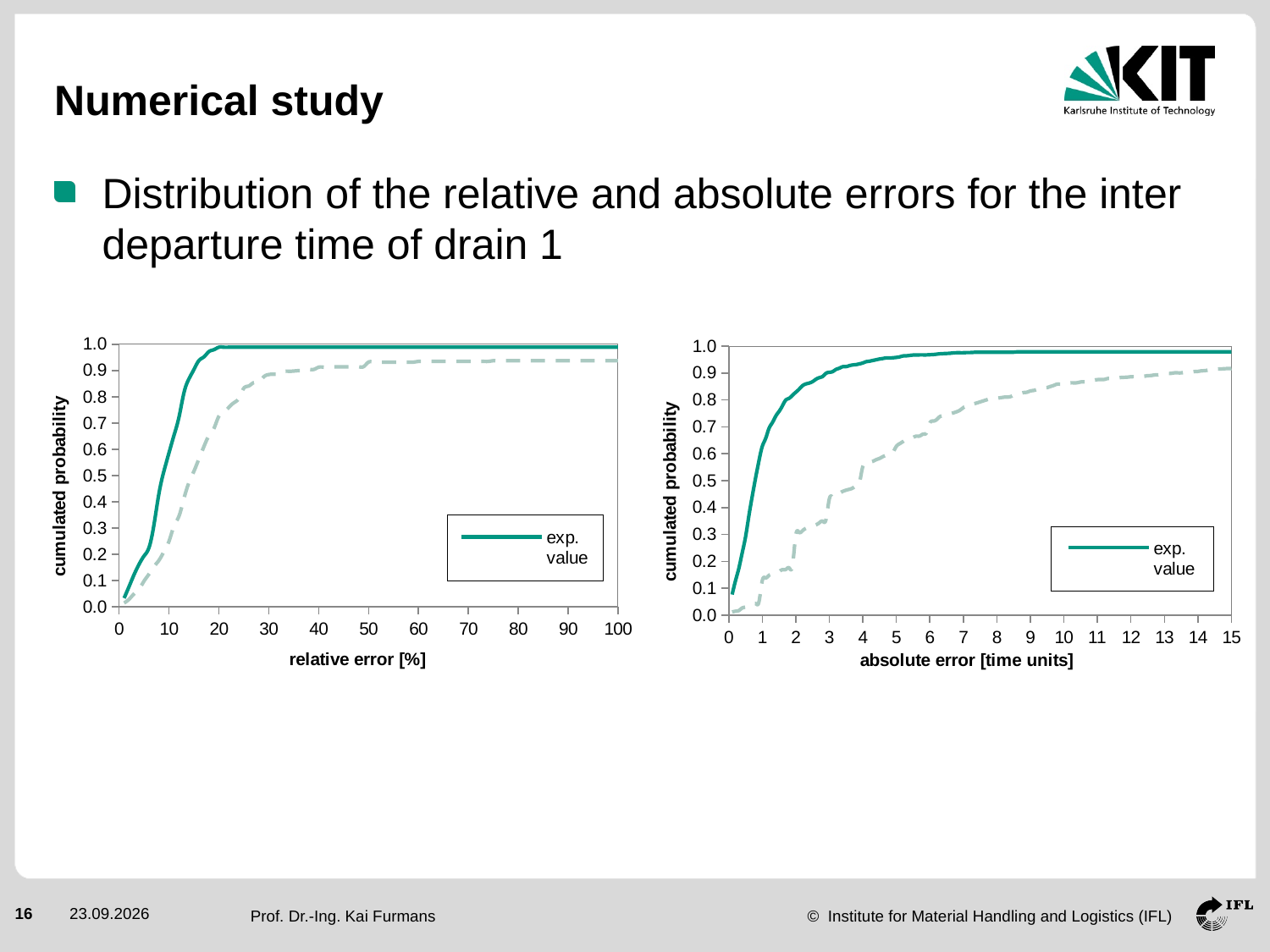
In the right chart, at an absolute error of 3 time units, which line has the higher cumulated probability, the solid 'exp. value' line or the dashed line? the solid 'exp. value' line In the right chart, what is the x-axis title? absolute error [time units] How many series does the legend of the left chart list? 1 What kind of chart is the left chart (relative error)? line chart In the right chart, is the value of the solid 'exp. value' line at an absolute error of 3 time units greater or less than 0.8? greater In the left chart, does the solid 'exp. value' line rise or fall as relative error increases? rise What kind of chart is the right chart (absolute error)? line chart In the right chart, does the dashed line rise or fall as absolute error increases? rise In the left chart, what is the x-axis title? relative error [%] In the left chart, is the value of the dashed line at a relative error of 10% greater or less than 0.5? less In the left chart, is the value of the solid 'exp. value' line at a relative error of 10% greater or less than 0.5? greater